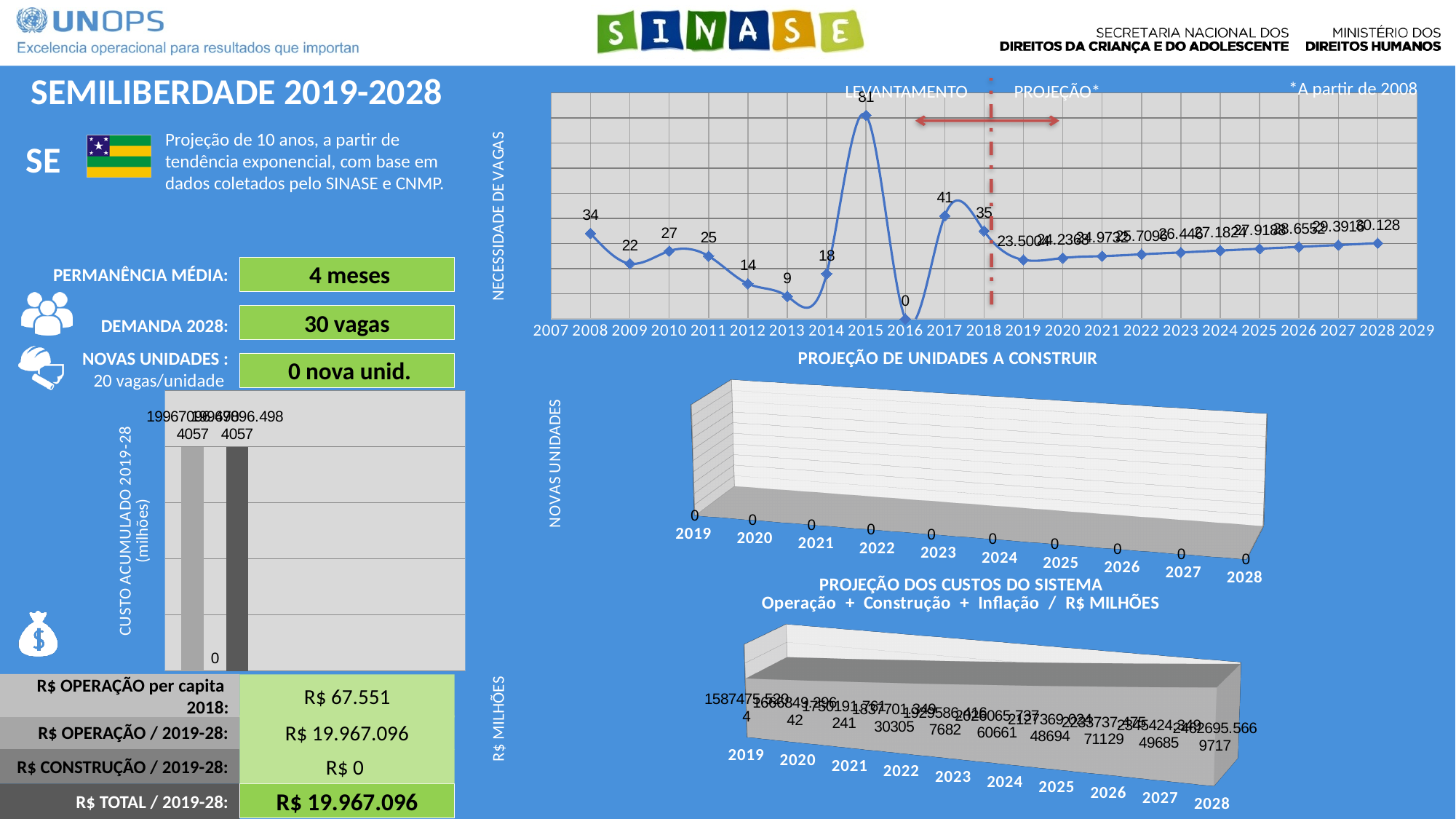
In the NECESSIDADE DE VAGAS line chart, what is the value for 2012? 14 In the PROJEÇÃO DE UNIDADES A CONSTRUIR chart, what is the value for 2024? 0 In the NECESSIDADE DE VAGAS line chart, which year has the highest value? 2015 In the NECESSIDADE DE VAGAS line chart, what is the value for 2016? 0 In the NECESSIDADE DE VAGAS line chart, what is the value for 2015? 81 In the NECESSIDADE DE VAGAS line chart, what is the difference between the values for 2017 and 2018? 6 In the NECESSIDADE DE VAGAS line chart, do the projected values rise or fall from 2019 to 2028? Rise In the NECESSIDADE DE VAGAS line chart, which year has the lowest value? 2016 What kind of chart is the PROJEÇÃO DE UNIDADES A CONSTRUIR chart? 3D area chart How many years are shown on the x axis of the PROJEÇÃO DE UNIDADES A CONSTRUIR chart? 10 What kind of chart is the NECESSIDADE DE VAGAS chart at the top right? Line chart In the NECESSIDADE DE VAGAS line chart, which year has the larger value, 2008 or 2009? 2008